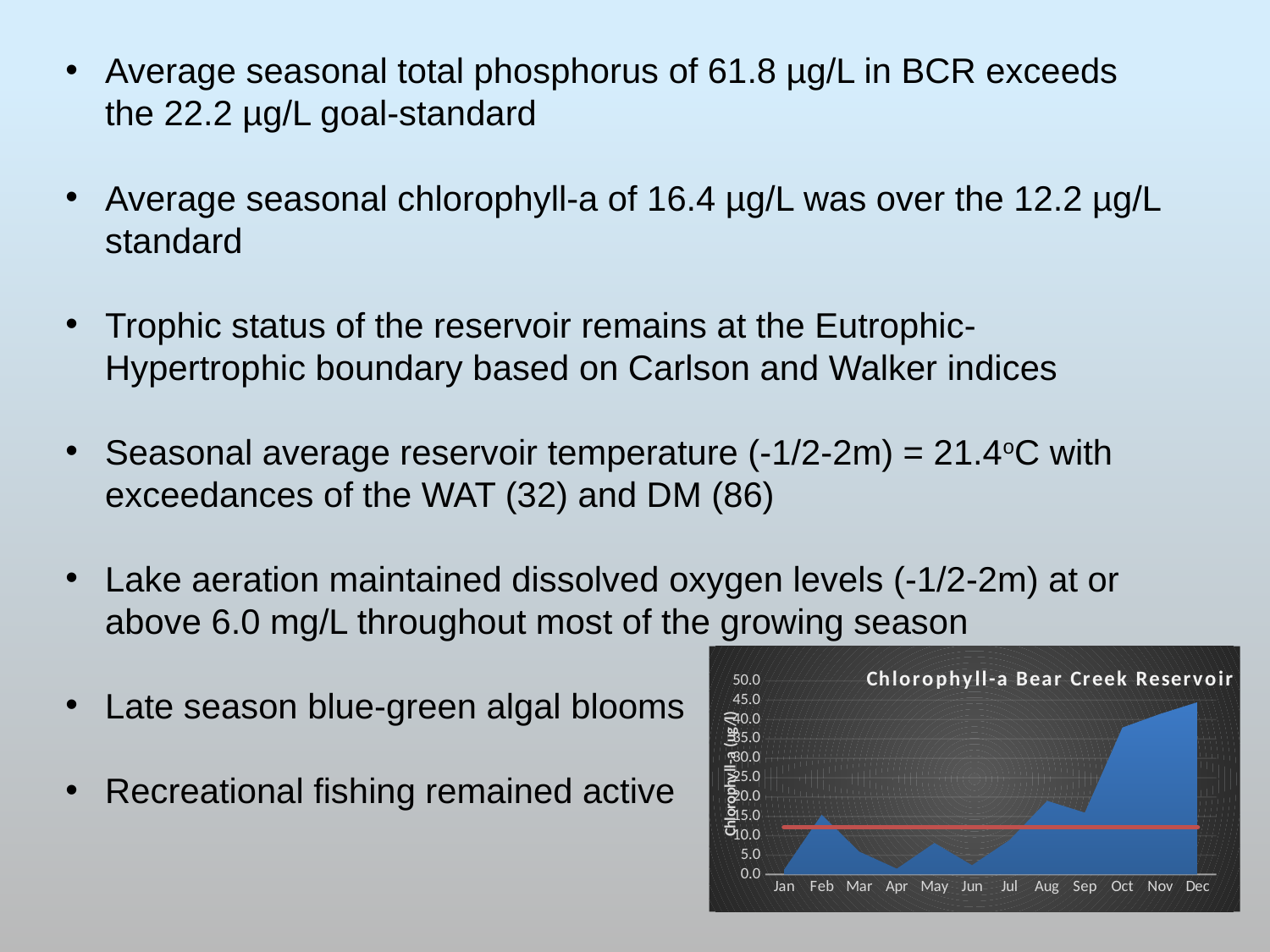
What is the title of the chart on the slide? Chlorophyll-a Bear Creek Reservoir How many months are shown on the x axis of the Chlorophyll-a Bear Creek Reservoir chart? 12 What kind of chart is the Chlorophyll-a Bear Creek Reservoir chart? area and line chart Which month has the higher chlorophyll-a value, Oct or Feb? Oct What is the highest tick value shown on the y axis of the Chlorophyll-a Bear Creek Reservoir chart? 50.0 Does chlorophyll-a rise or fall from Aug to Nov in the Chlorophyll-a Bear Creek Reservoir chart? rise Is the chlorophyll-a value for Feb greater or less than 10.0? greater Is the chlorophyll-a value for Oct greater or less than 30.0? greater Is the chlorophyll-a value for Sep greater or less than 10.0? greater In which month does chlorophyll-a reach its highest value in the Chlorophyll-a Bear Creek Reservoir chart? Dec